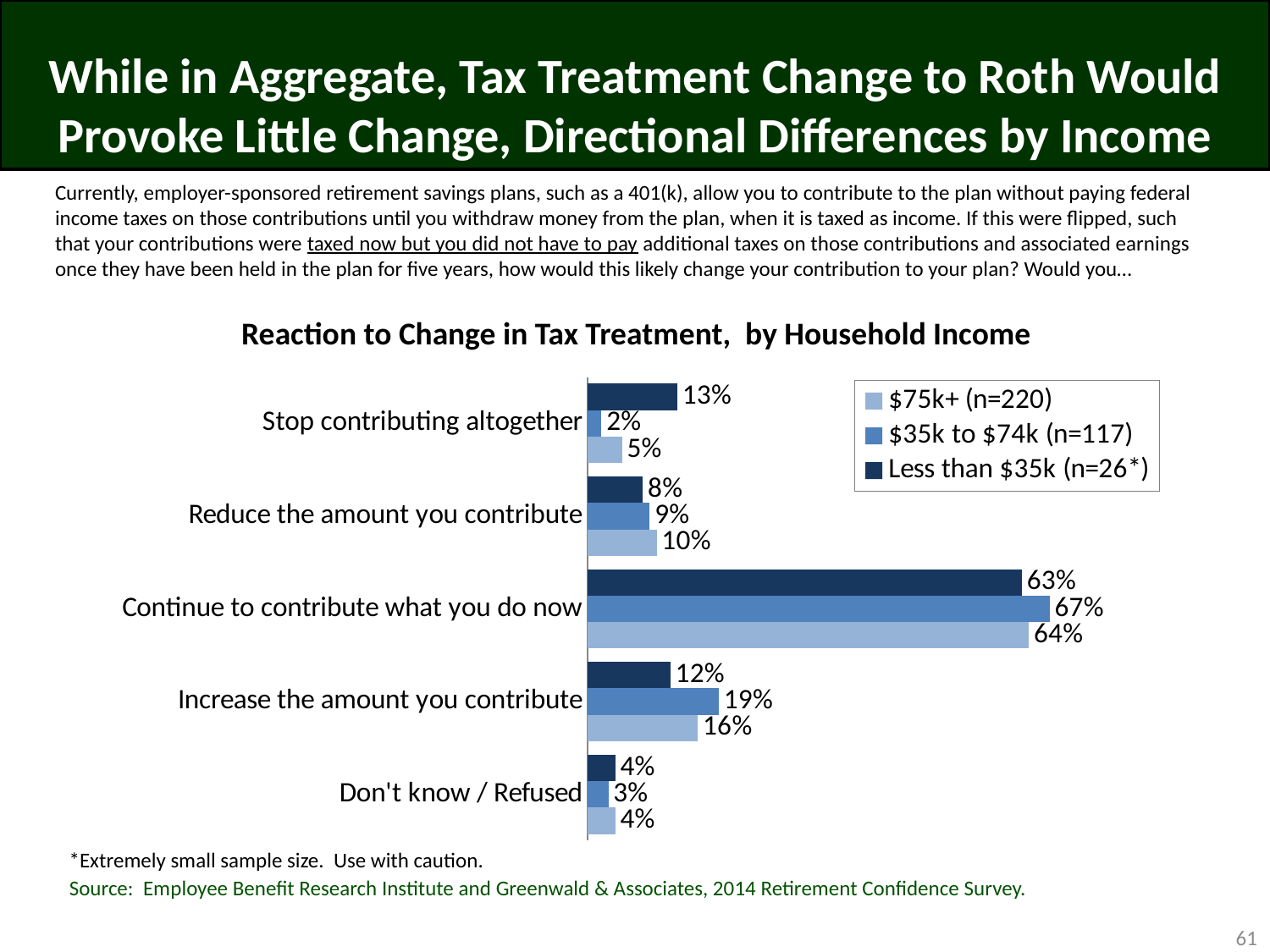
What percentage of the Less than $35k group would stop contributing altogether? 13% For 'Stop contributing altogether', which is larger: the Less than $35k value or the $75k+ value? Less than $35k What is the difference between the $35k to $74k and Less than $35k values for 'Increase the amount you contribute'? 7% Which income group has the lowest value for 'Stop contributing altogether'? $35k to $74k (n=117) How many response categories are shown on the chart? 5 What is the title of the chart? Reaction to Change in Tax Treatment, by Household Income What percentage of the $75k+ group would increase the amount they contribute? 16% What percentage of the $75k+ group would reduce the amount they contribute? 10% Which response category has the highest value for the Less than $35k group? Continue to contribute what you do now What type of chart is shown on the slide? Bar chart How many series does the legend list? 3 What percentage of the $35k to $74k group would continue to contribute what they do now? 67%